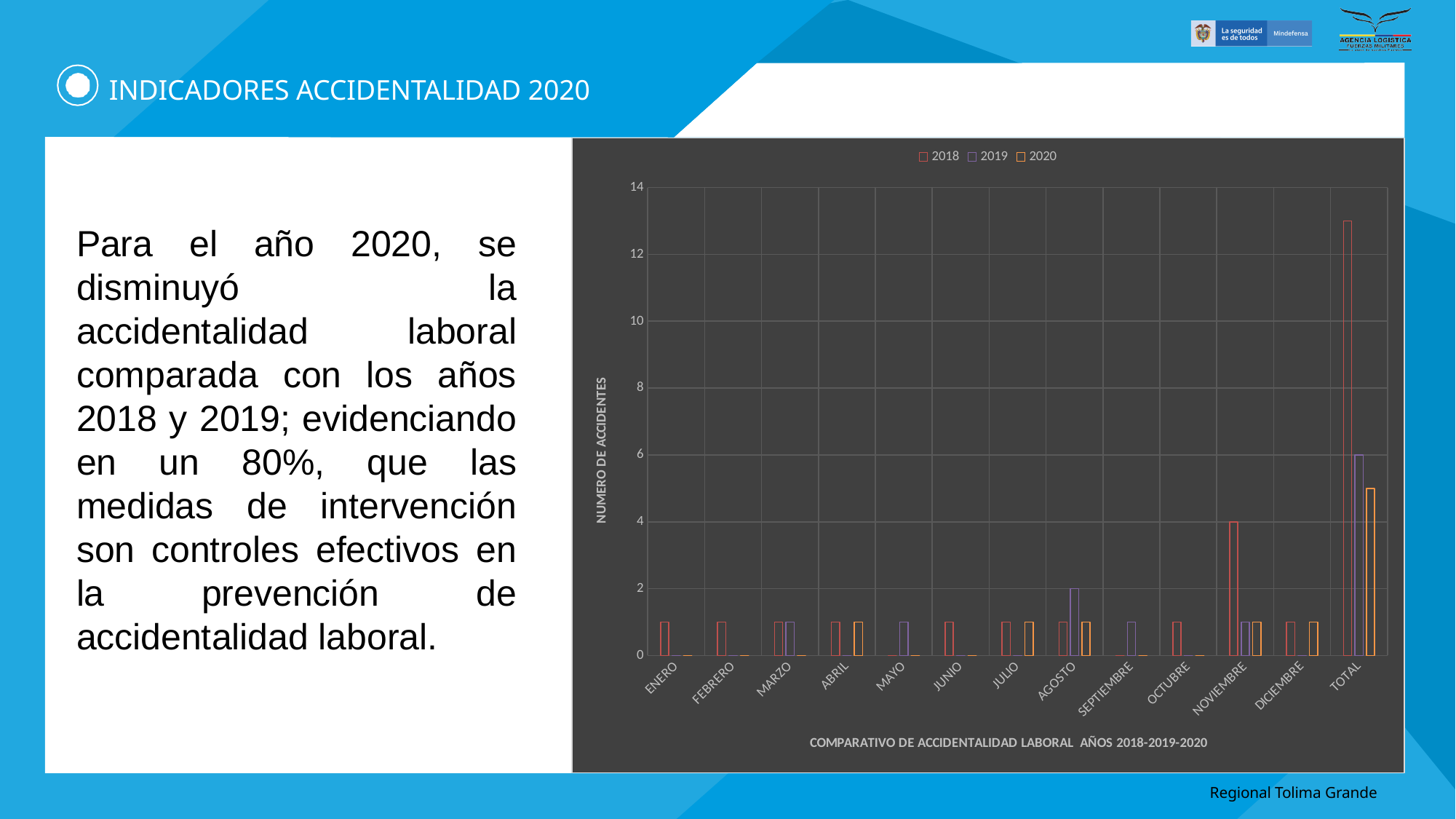
How many series does the chart legend list? 3 What is the difference between the 2019 TOTAL value and the 2018 NOVIEMBRE value? 2 Is the value for 2018 in the TOTAL category greater or less than 12? greater How many categories are shown along the x axis of the chart? 13 What is the value for 2019 in AGOSTO? 2 What kind of chart is shown on the slide? bar chart What is the value for 2018 in NOVIEMBRE? 4 Which series has the highest value in the TOTAL category? 2018 Which is larger in the TOTAL category, the value for 2018 or the value for 2019? 2018 What is the value for 2019 in the TOTAL category? 6 What is the title shown below the chart? COMPARATIVO DE ACCIDENTALIDAD LABORAL AÑOS 2018-2019-2020 Is the value for 2020 in the TOTAL category greater or less than 6? less